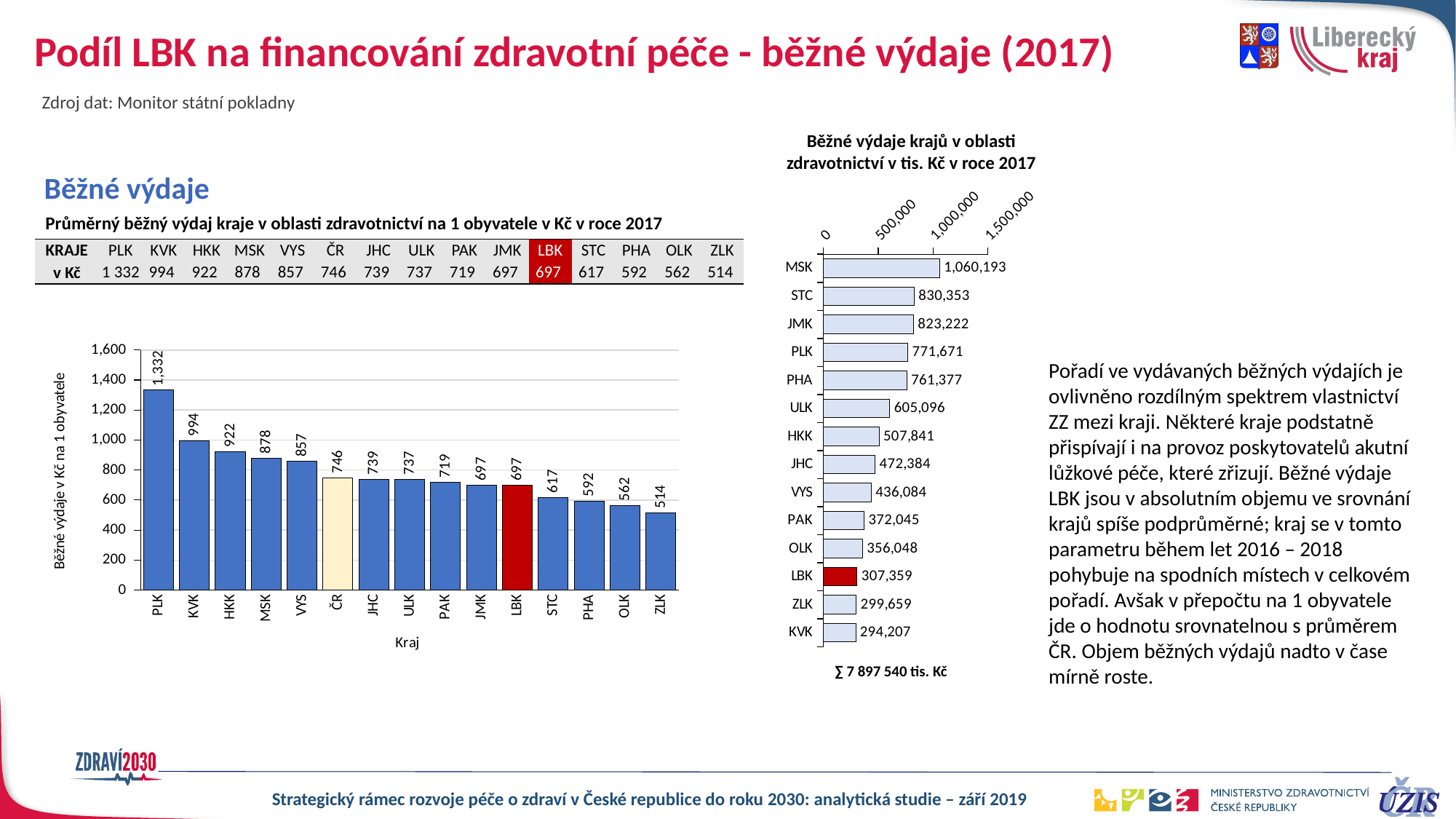
In the right chart (Běžné výdaje krajů v oblasti zdravotnictví v tis. Kč v roce 2017), which region has the lowest value? KVK In the left chart (Běžné výdaje v Kč na 1 obyvatele), which region has the highest value? PLK In the right chart (Běžné výdaje krajů v oblasti zdravotnictví v tis. Kč v roce 2017), which region has the highest value? MSK In the left chart (Běžné výdaje v Kč na 1 obyvatele), how many bars are plotted? 15 In the left chart (Běžné výdaje v Kč na 1 obyvatele), what is the value for ČR? 746 In the left chart (Běžné výdaje v Kč na 1 obyvatele), what is the difference between PLK and KVK? 338 In the left chart (Běžné výdaje v Kč na 1 obyvatele), which region has the lowest value? ZLK What type of chart is the right chart (Běžné výdaje krajů v oblasti zdravotnictví v tis. Kč v roce 2017)? Bar chart In the right chart (Běžné výdaje krajů v oblasti zdravotnictví v tis. Kč v roce 2017), which is larger, STC or JMK? STC In the left chart (Běžné výdaje v Kč na 1 obyvatele), what is the value for LBK? 697 In the right chart (Běžné výdaje krajů v oblasti zdravotnictví v tis. Kč v roce 2017), what is the value for LBK? 307,359 In the right chart (Běžné výdaje krajů v oblasti zdravotnictví v tis. Kč v roce 2017), how many regions are plotted? 14